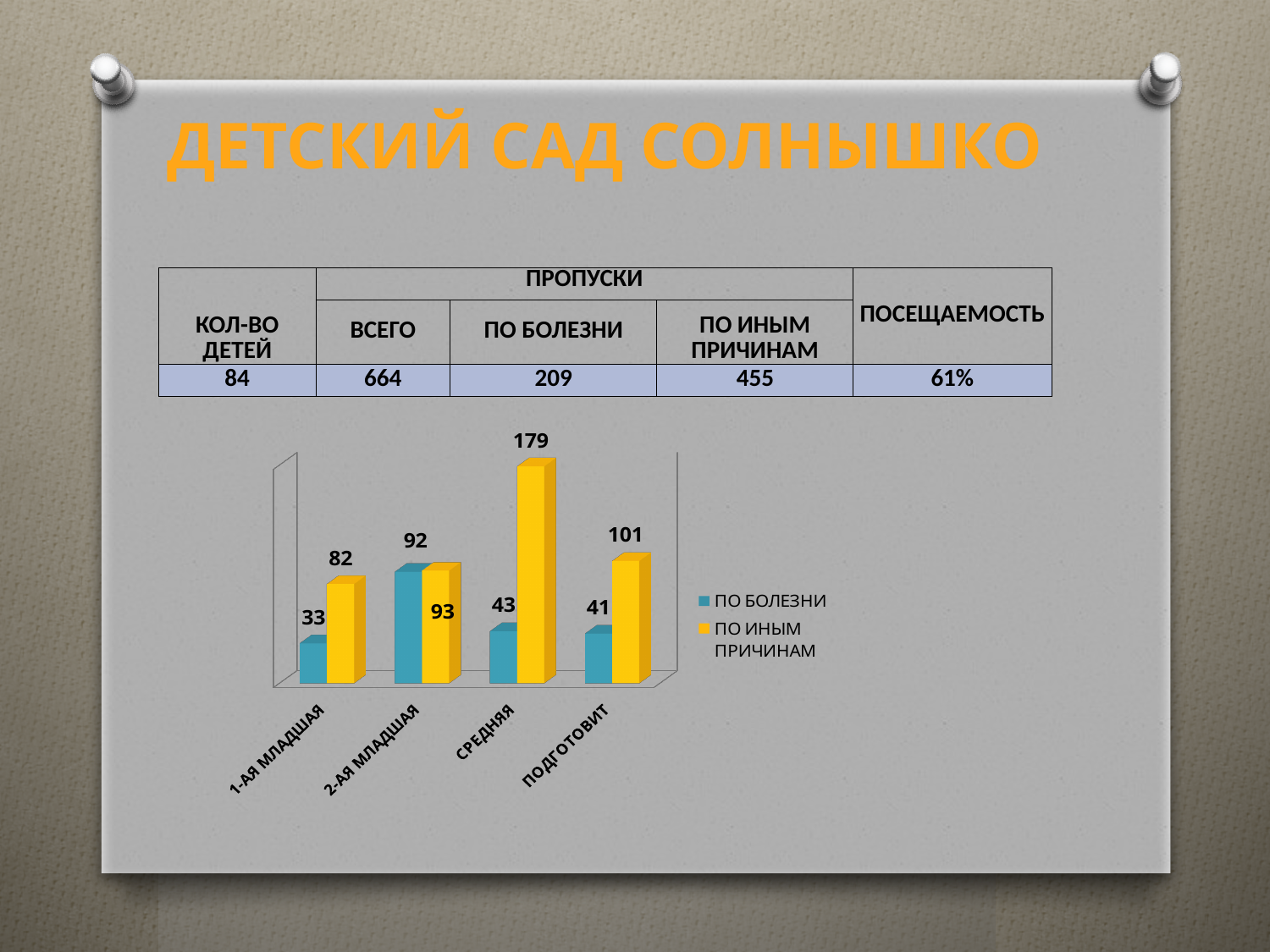
What is the value of ПО БОЛЕЗНИ for 2-АЯ МЛАДШАЯ? 92 What colour are the bars for the ПО БОЛЕЗНИ series? blue What type of chart is shown on the slide? bar chart Which category has the lowest value for ПО БОЛЕЗНИ? 1-АЯ МЛАДШАЯ Which category has the highest value for ПО ИНЫМ ПРИЧИНАМ? СРЕДНЯЯ What is the value of ПО ИНЫМ ПРИЧИНАМ for СРЕДНЯЯ? 179 How many series does the chart legend list? 2 How many categories are shown on the chart's x axis? 4 What is the value of ПО ИНЫМ ПРИЧИНАМ for ПОДГОТОВИТ? 101 Which is larger for ПОДГОТОВИТ: ПО БОЛЕЗНИ or ПО ИНЫМ ПРИЧИНАМ? ПО ИНЫМ ПРИЧИНАМ What is the value of ПО БОЛЕЗНИ for 1-АЯ МЛАДШАЯ? 33 What is the difference between ПО ИНЫМ ПРИЧИНАМ and ПО БОЛЕЗНИ for СРЕДНЯЯ? 136